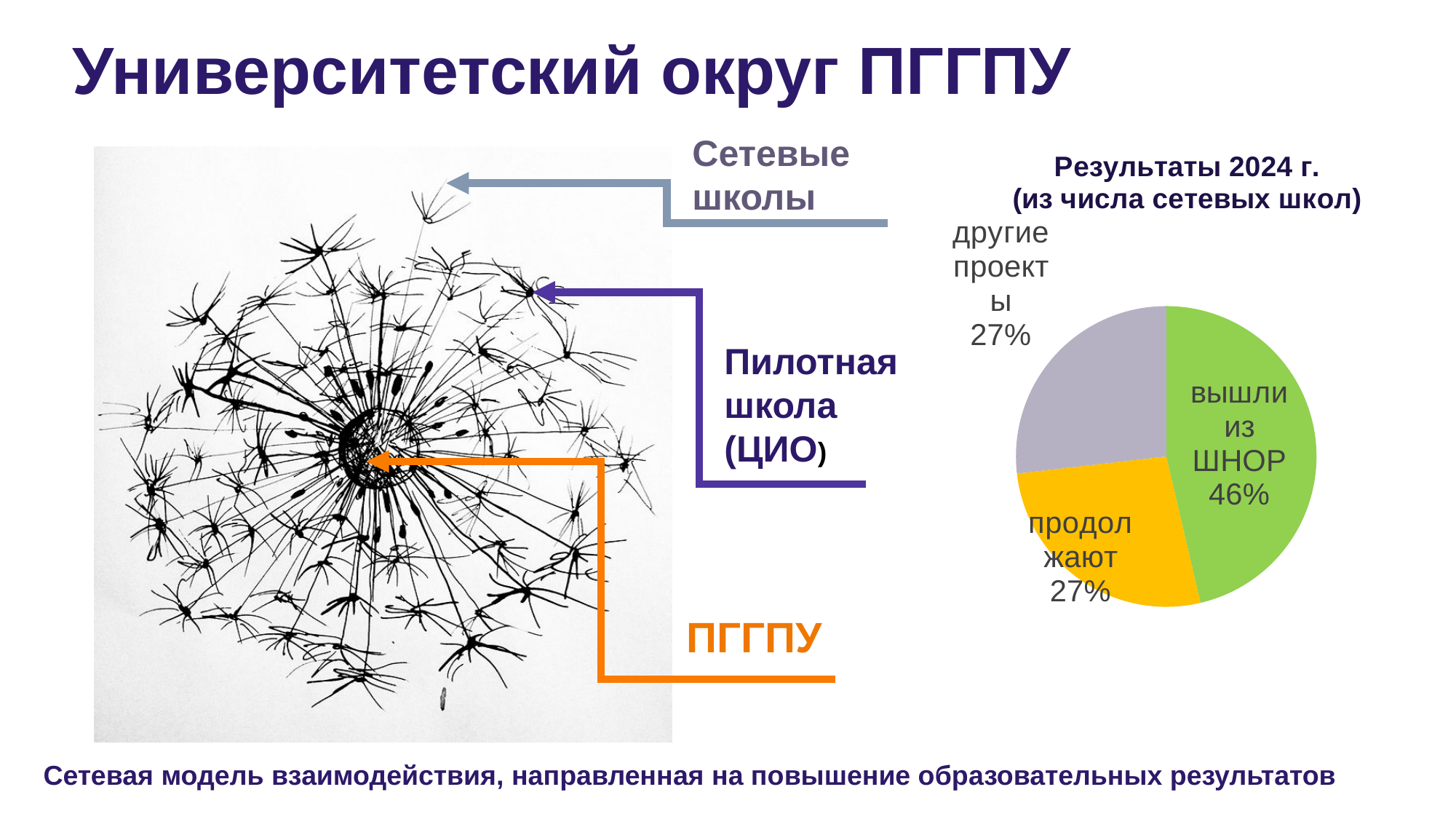
What colour is the "вышли из ШНОР" slice? green What is the value shown for "другие проекты"? 27% What is the difference in percentage points between "вышли из ШНОР" and "другие проекты"? 19 Which is larger: "вышли из ШНОР" or "продолжают"? вышли из ШНОР What do the three slice percentages add up to? 100% How many slices does the pie chart have? 3 What is the title of the pie chart? Результаты 2024 г. (из числа сетевых школ) Do "продолжают" and "другие проекты" have the same share of the pie? yes What is the value shown for "продолжают"? 27% What share of the pie is labelled "вышли из ШНОР"? 46% What kind of chart is shown on the slide? pie chart Which slice of the pie chart is the largest? вышли из ШНОР